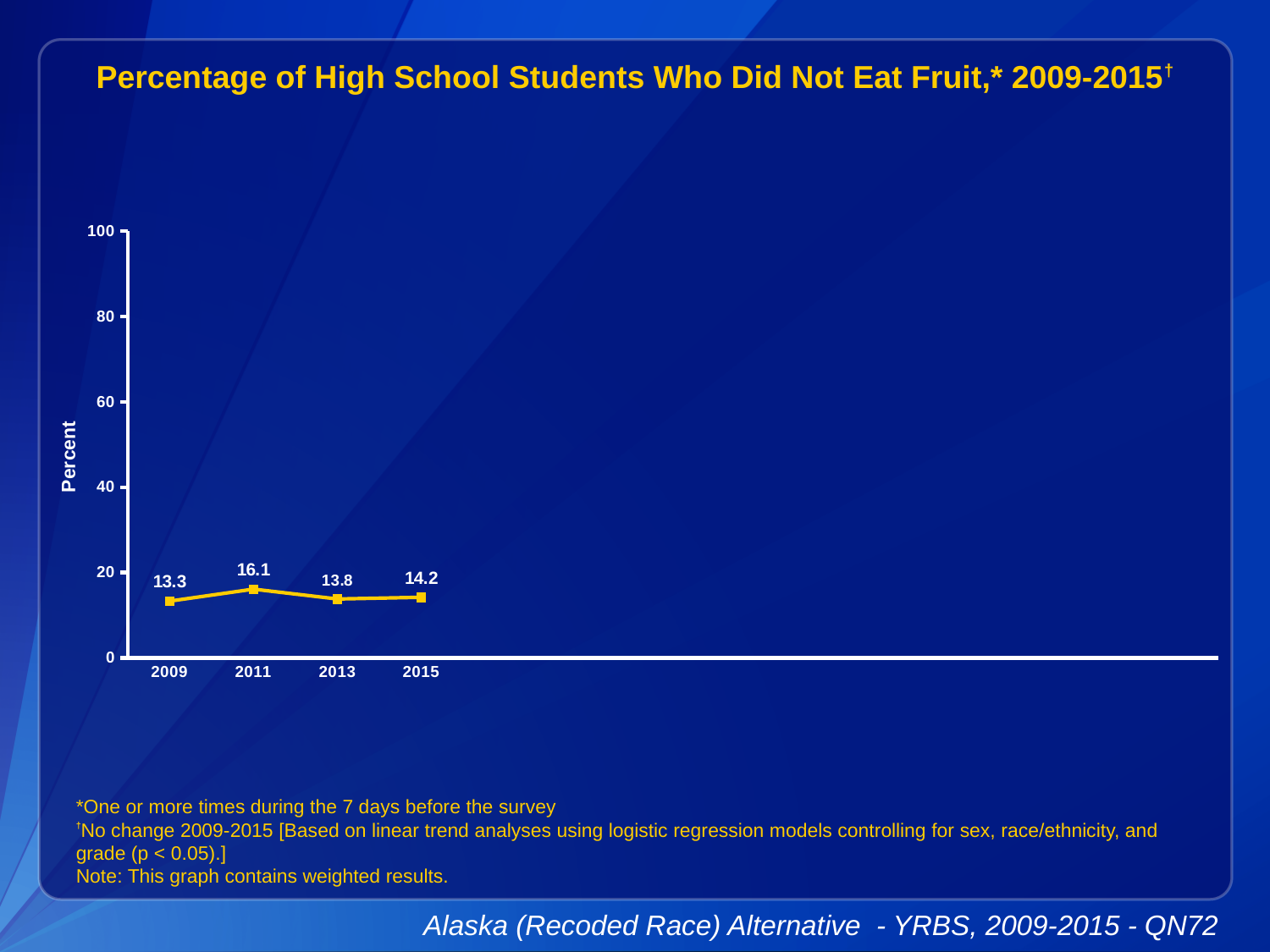
How many data points are plotted on the chart? 4 Which year has the lowest value? 2009 What is the value for 2011? 16.1 Is the value for 2011 greater or less than 20? less What is the value for 2015? 14.2 Which is larger, the value for 2015 or the value for 2013? 2015 What kind of chart is shown on the slide? line chart What is the value for 2013? 13.8 What is the difference between the values for 2011 and 2009? 2.8 What is the value for 2009? 13.3 Which year has the highest value? 2011 What is the label on the y axis? Percent